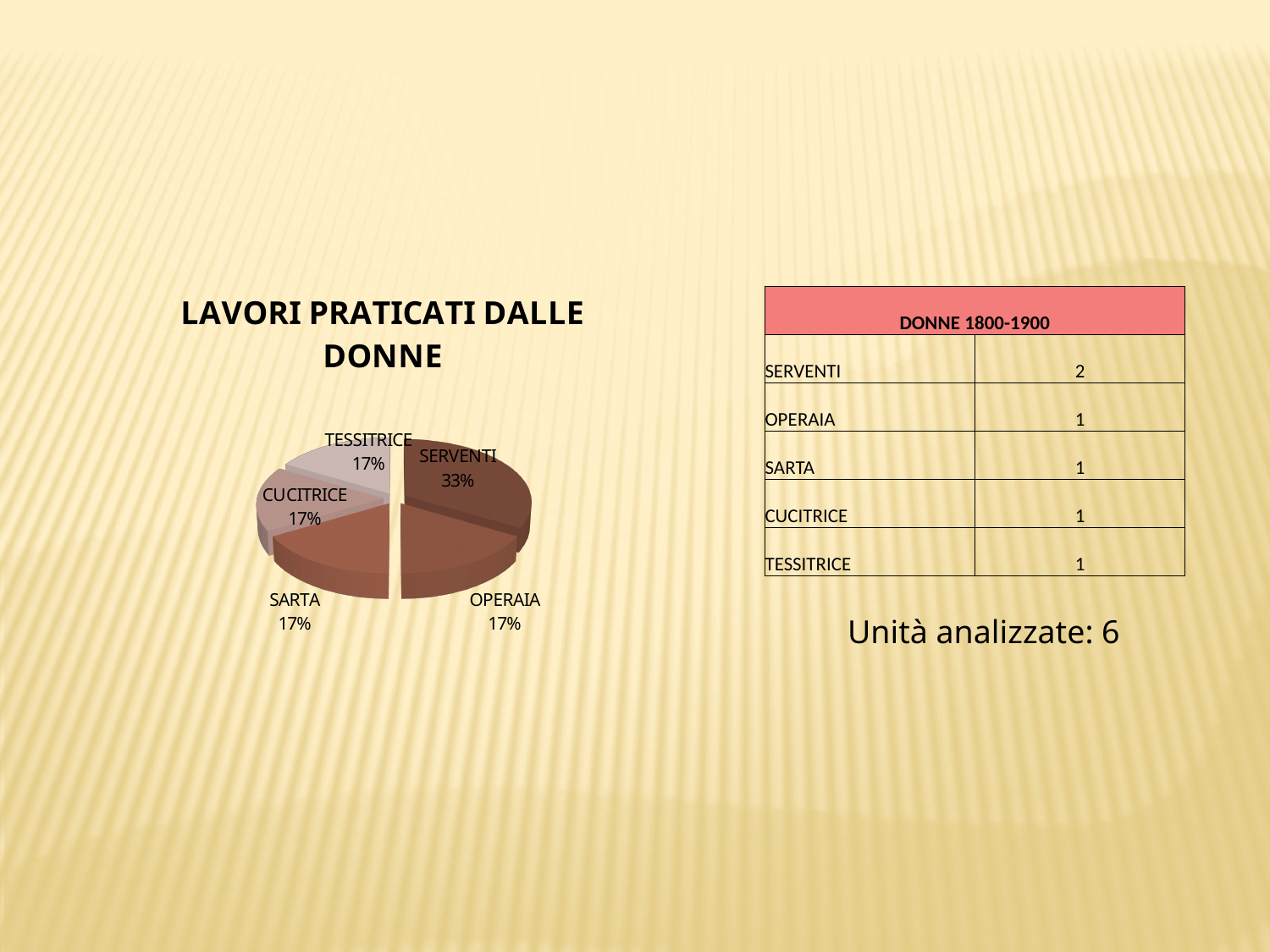
What is the title of the chart? LAVORI PRATICATI DALLE DONNE What is the percentage label shown for CUCITRICE? 17% What share of the pie does TESSITRICE represent? 17% What is the difference in percentage points between the SERVENTI slice and the SARTA slice? 16% Which is larger, the SERVENTI slice or the CUCITRICE slice? SERVENTI What share of the pie does SERVENTI represent? 33% How many slices does the pie chart have? 5 What share of the pie does OPERAIA represent? 17% Which category has the largest slice of the pie? SERVENTI What is the percentage label shown for SARTA? 17% What kind of chart is shown on the slide? pie chart